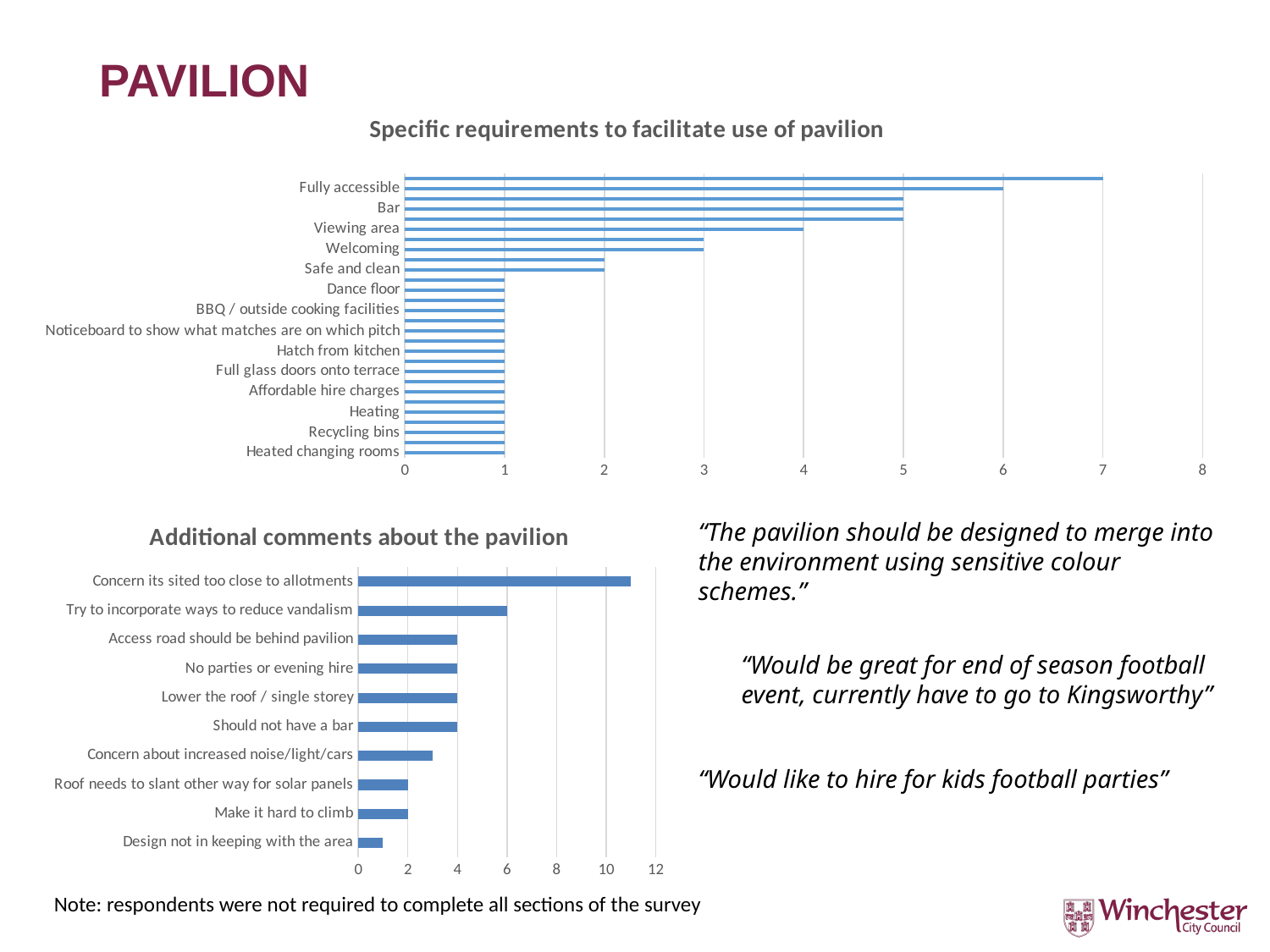
In the 'Additional comments about the pavilion' chart, which category has the highest value? Concern its sited too close to allotments What kind of chart is the 'Additional comments about the pavilion' chart? bar chart In the 'Additional comments about the pavilion' chart, what is the value for 'Try to incorporate ways to reduce vandalism'? 6 In the 'Specific requirements to facilitate use of pavilion' chart, what is the highest value reached by any bar? 7 In the 'Additional comments about the pavilion' chart, what is the value for 'Make it hard to climb'? 2 In the 'Additional comments about the pavilion' chart, is the value for 'Concern its sited too close to allotments' greater or less than 10? greater In the 'Additional comments about the pavilion' chart, which category has the lowest value? Design not in keeping with the area In the 'Additional comments about the pavilion' chart, what is the value for 'Access road should be behind pavilion'? 4 In the 'Additional comments about the pavilion' chart, is the value for 'Design not in keeping with the area' greater or less than 2? less In the 'Additional comments about the pavilion' chart, which is larger: 'Try to incorporate ways to reduce vandalism' or 'Roof needs to slant other way for solar panels'? Try to incorporate ways to reduce vandalism In the 'Additional comments about the pavilion' chart, how many categories are shown? 10 In the 'Additional comments about the pavilion' chart, what is the difference between 'Try to incorporate ways to reduce vandalism' and 'Should not have a bar'? 2